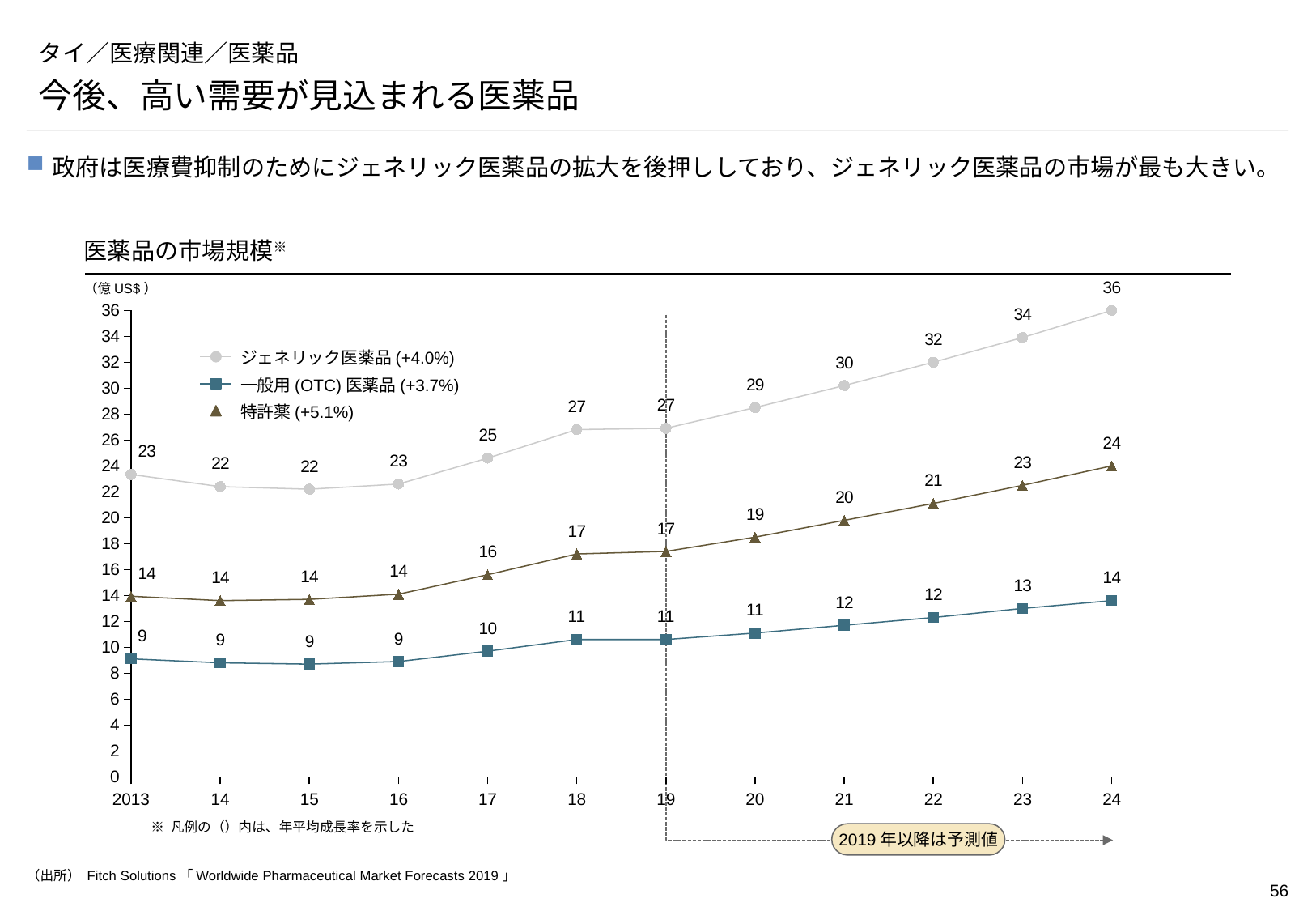
What is the difference between the ジェネリック医薬品 value and the 特許薬 value in 2024? 12 Which series has the lowest value in 2019? 一般用 (OTC) 医薬品 What type of chart is shown on the slide? line chart What unit is shown for the y axis? 億 US$ What is the value for 一般用 (OTC) 医薬品 in 2017? 10 What is the value for 特許薬 in 2013? 14 What is the value for ジェネリック医薬品 in 2024? 36 Which series has the highest value in 2024? ジェネリック医薬品 How many series does the legend list? 3 Does the value for ジェネリック医薬品 rise or fall from 2019 to 2024? rise How many years are plotted on the x axis? 12 Which is larger in 2020: the value for 特許薬 or the value for 一般用 (OTC) 医薬品? 特許薬